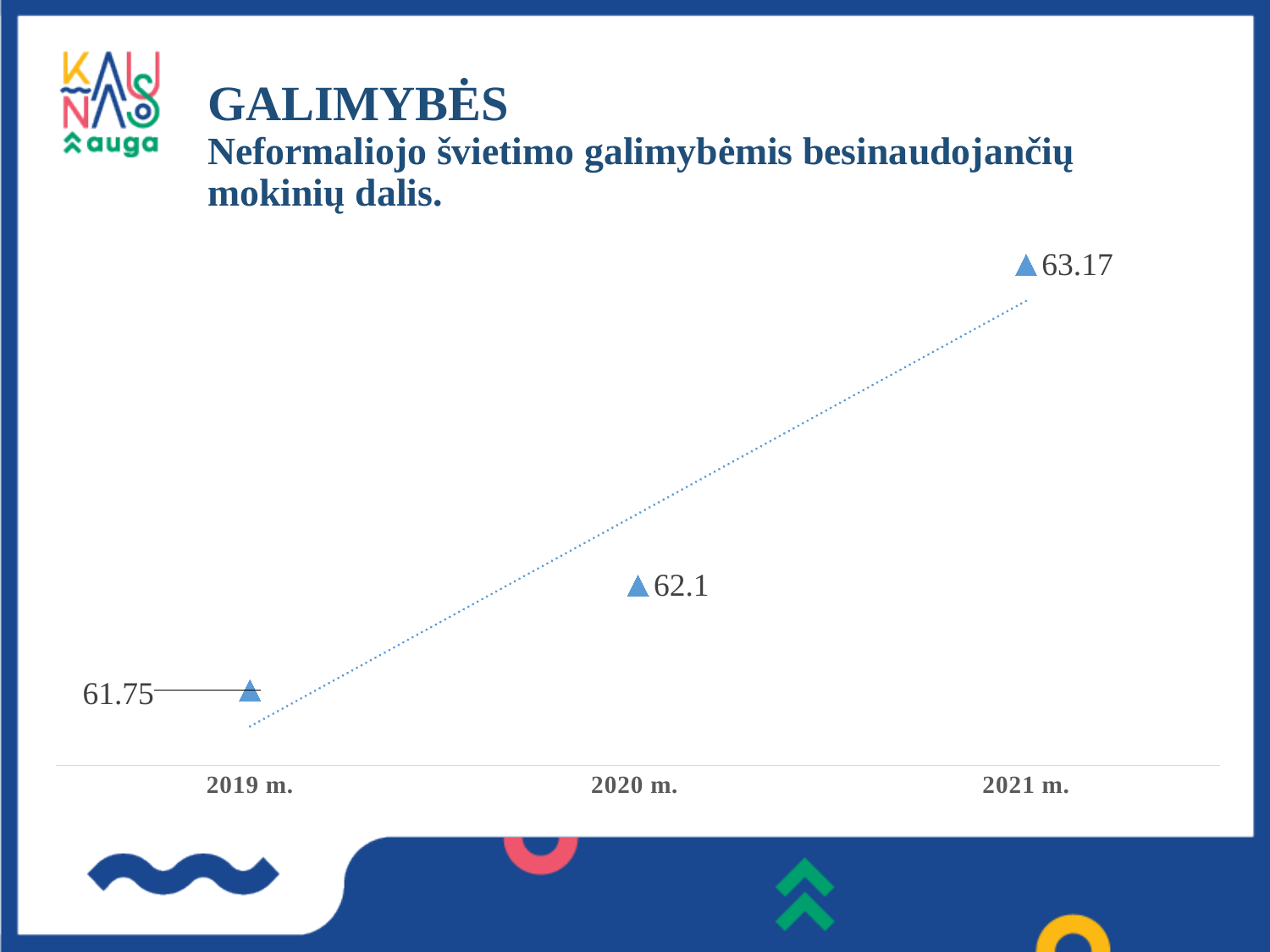
How many data points are plotted on the chart? 3 What is the subtitle of the chart shown on the slide? Neformaliojo švietimo galimybėmis besinaudojančių mokinių dalis. What is the difference between the values for 2020 m. and 2019 m.? 0.35 What is the value for 2019 m.? 61.75 What marker shape is used for the data points? triangles Do the values rise or fall from 2019 m. to 2021 m.? rise Which year has the lowest value? 2019 m. What is the value for 2021 m.? 63.17 What is the value for 2020 m.? 62.1 Which is larger, the value for 2020 m. or the value for 2021 m.? 2021 m. Which year has the highest value? 2021 m. What is the difference between the values for 2021 m. and 2019 m.? 1.42